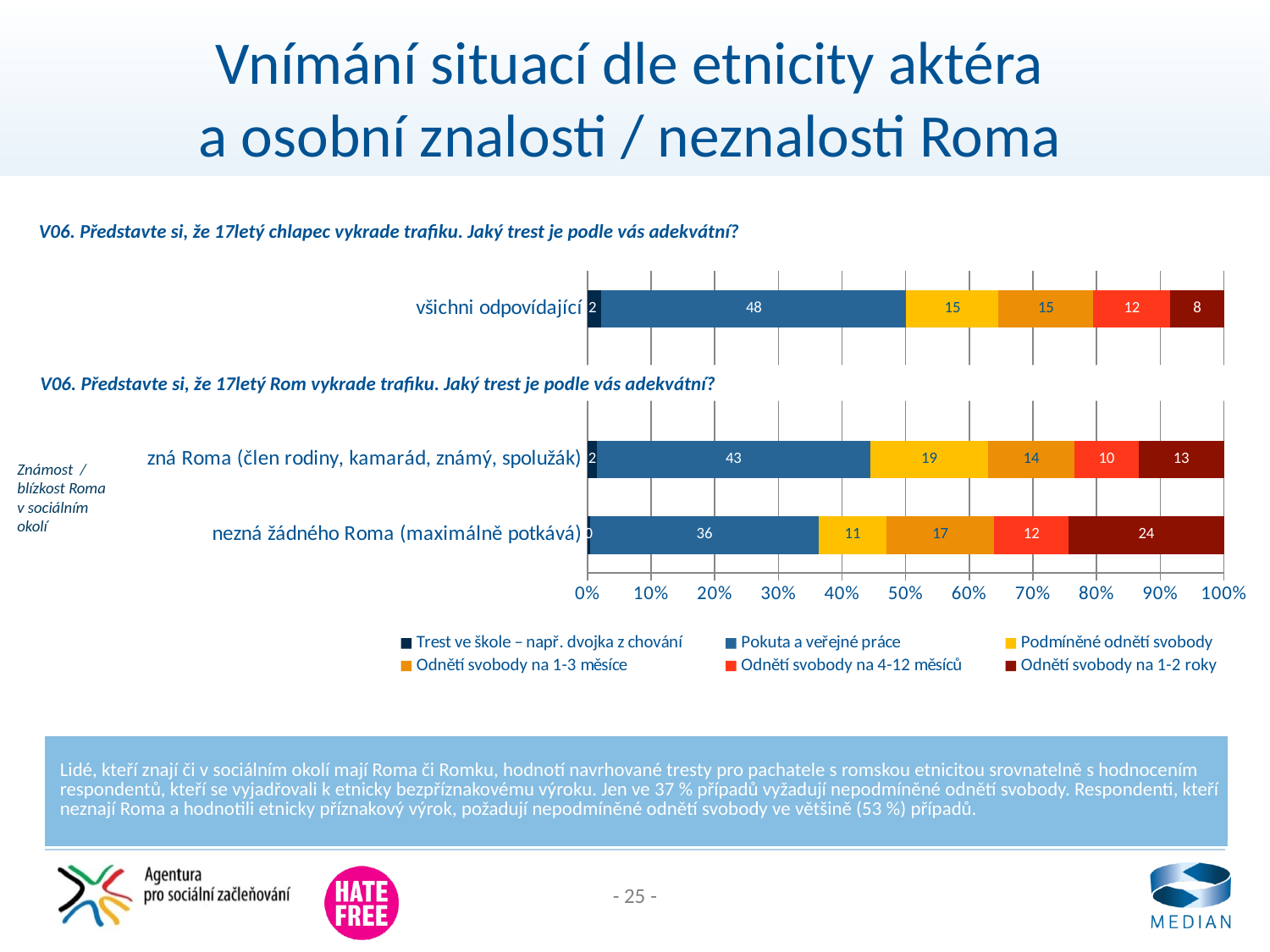
In the bottom chart (17letý Rom), what is the difference between the 'Pokuta a veřejné práce' values for 'zná Roma' and 'nezná žádného Roma'? 7 In the bottom chart (17letý Rom), which series has the largest value for 'nezná žádného Roma (maximálně potkává)'? Pokuta a veřejné práce In the top chart (17letý chlapec), what is the value for 'Pokuta a veřejné práce' for 'všichni odpovídající'? 48 What kind of chart is used on this slide? Stacked bar chart In the bottom chart (17letý Rom), what is the value for 'Odnětí svobody na 1-2 roky' for 'nezná žádného Roma (maximálně potkává)'? 24 In the bottom chart (17letý Rom), which category has the higher value for 'Odnětí svobody na 1-2 roky': 'zná Roma' or 'nezná žádného Roma'? nezná žádného Roma (maximálně potkává) In the bottom chart (17letý Rom), what is the value for 'Pokuta a veřejné práce' for 'zná Roma (člen rodiny, kamarád, známý, spolužák)'? 43 How many categories (bars) are shown in the bottom chart (17letý Rom)? 2 How many series does the legend list? 6 In the bottom chart (17letý Rom), what is the value for 'Podmíněné odnětí svobody' for 'zná Roma'? 19 In the top chart (17letý chlapec), what is the value for 'Odnětí svobody na 1-2 roky' for 'všichni odpovídající'? 8 In the top chart (17letý chlapec), what is the difference between the 'Pokuta a veřejné práce' value and the 'Odnětí svobody na 4-12 měsíců' value? 36